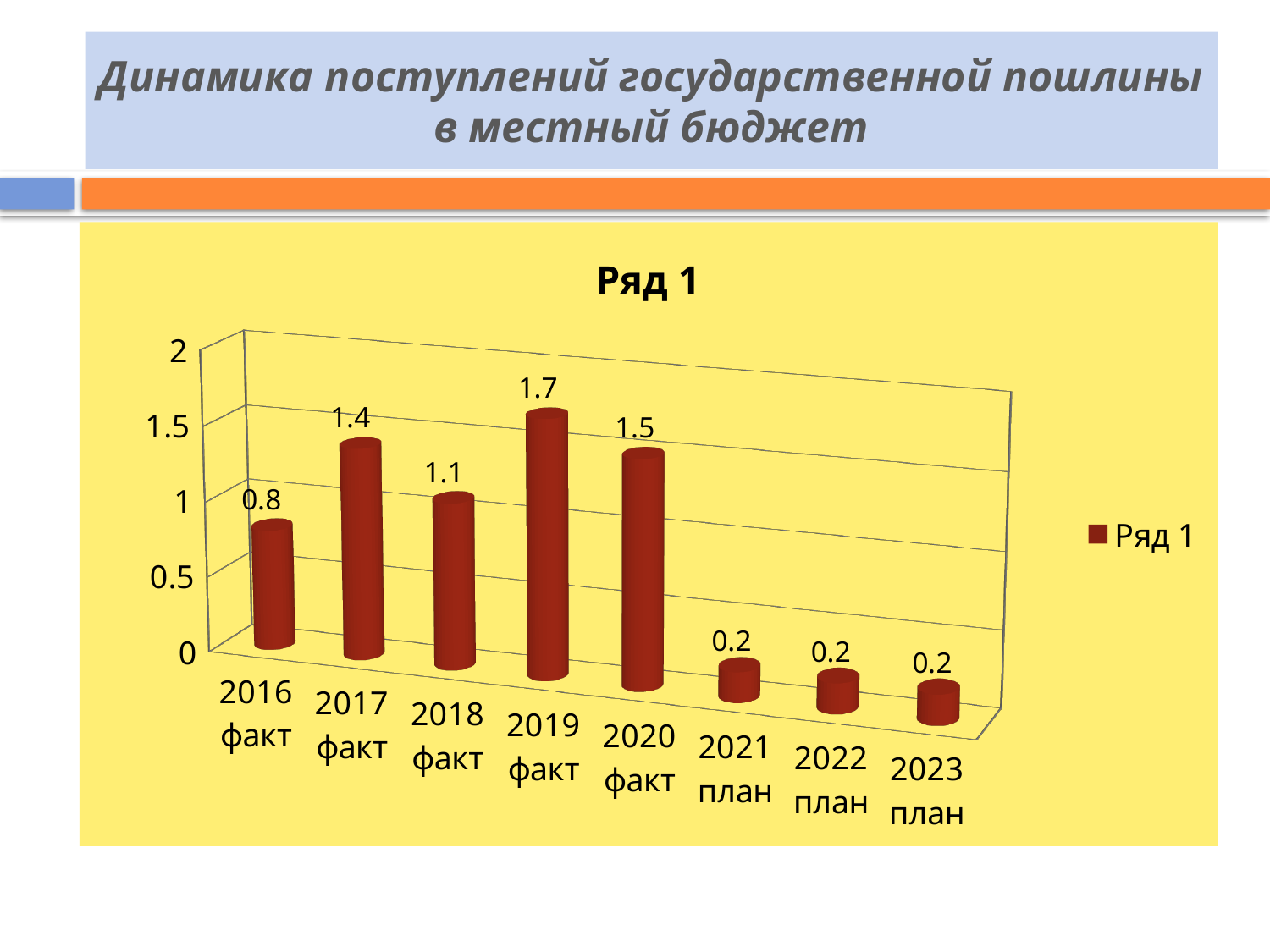
What is the difference between the values for 2017 факт and 2016 факт? 0.6 Which category has the highest value? 2019 факт What is the value for 2019 факт? 1.7 Which is larger, the value for 2018 факт or the value for 2020 факт? 2020 факт What is the difference between the values for 2019 факт and 2020 факт? 0.2 How many categories are shown on the x axis? 8 Is the value for 2017 факт greater or less than 1? greater What kind of chart is shown on the slide? bar chart What is the value for 2022 план? 0.2 What is the value for 2016 факт? 0.8 What is the title of the chart? Ряд 1 How many series does the legend list? 1